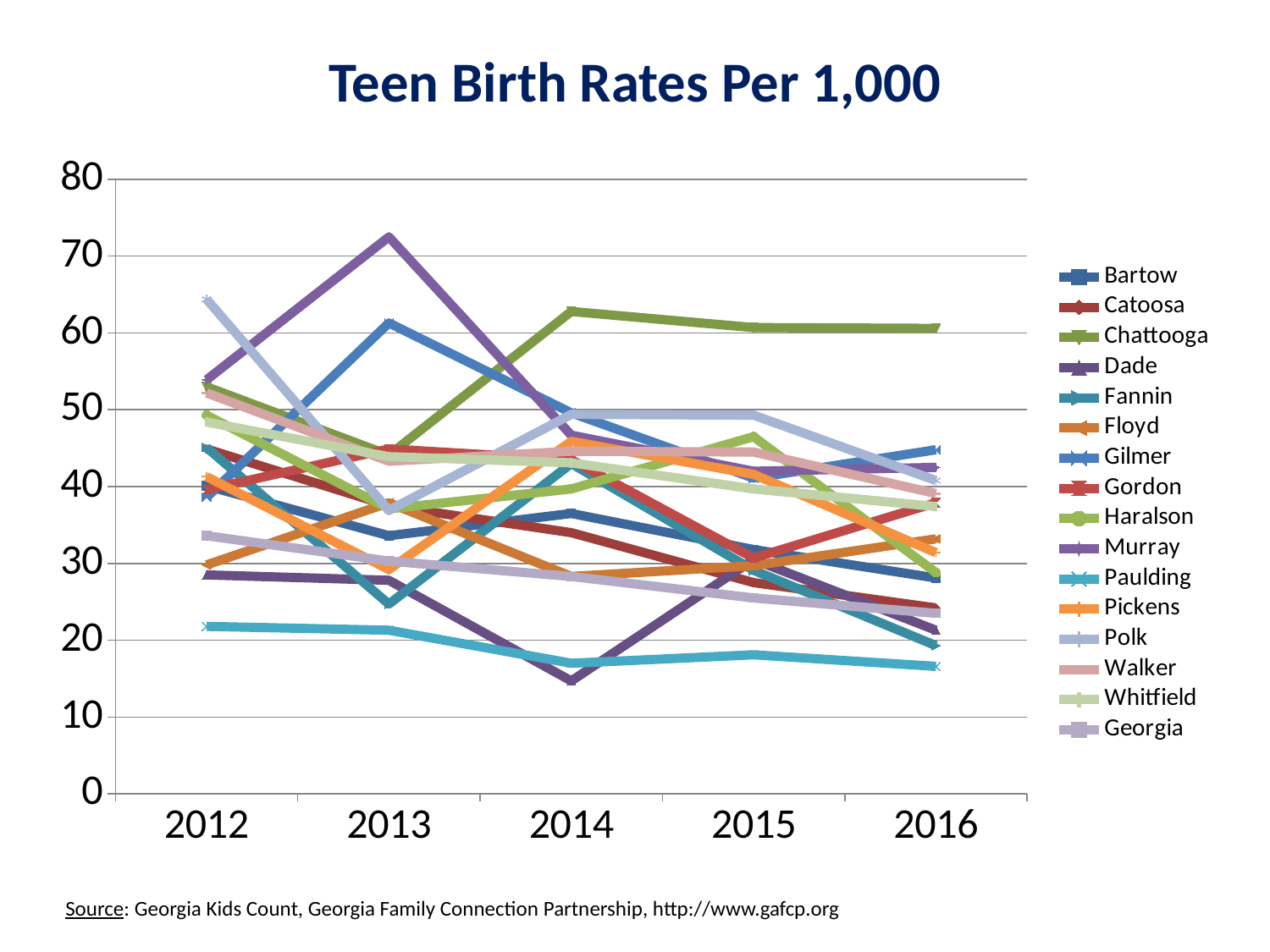
What kind of chart is shown on the slide? line chart How many years are shown on the x axis? 5 Is the value for Paulding in 2016 greater or less than 20? less Which series has the highest value in 2016? Chattooga What is the title of the chart? Teen Birth Rates Per 1,000 In 2012, which is larger, the value for Polk or the value for Paulding? Polk Which series has the lowest value in 2014? Dade Is the value for Murray in 2013 greater or less than 70? greater Which series has the highest value in 2013? Murray Does the Georgia series rise or fall from 2012 to 2016? fall How many series does the legend list? 16 Is the value for Chattooga in 2014 greater or less than 60? greater